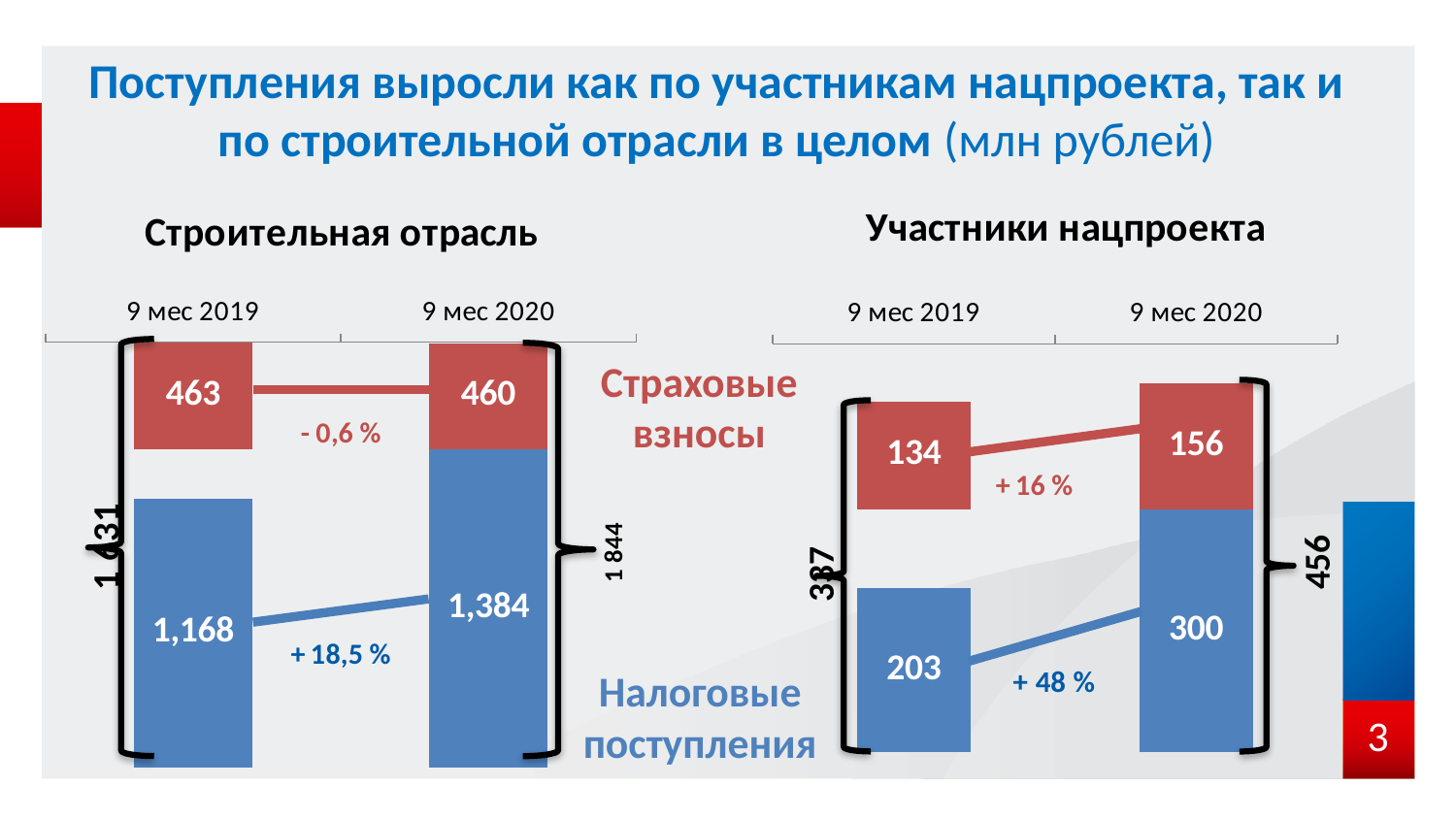
In the 'Строительная отрасль' chart, what percentage change in Страховые взносы is shown between 9 мес 2019 and 9 мес 2020? - 0,6 % How many series are shown in each chart on the slide? 2 In the 'Участники нацпроекта' chart, what percentage change in Налоговые поступления is shown between 9 мес 2019 and 9 мес 2020? + 48 % In the 'Участники нацпроекта' chart, what is the difference in Налоговые поступления between 9 мес 2020 and 9 мес 2019? 97 In the 'Строительная отрасль' chart, which period has the larger value of Страховые взносы, 9 мес 2019 or 9 мес 2020? 9 мес 2019 In the 'Участники нацпроекта' chart, what is the total of the stacked bar for 9 мес 2019? 337 In the 'Строительная отрасль' chart, what is the value of Страховые взносы for 9 мес 2019? 463 In the 'Строительная отрасль' chart, what is the total of the stacked bar for 9 мес 2020? 1 844 In the 'Участники нацпроекта' chart, what is the value of Страховые взносы for 9 мес 2020? 156 In the 'Строительная отрасль' chart, what is the value of Налоговые поступления for 9 мес 2020? 1,384 In the 'Участники нацпроекта' chart, what is the value of Налоговые поступления for 9 мес 2019? 203 What type of chart is used on this slide? Stacked bar chart